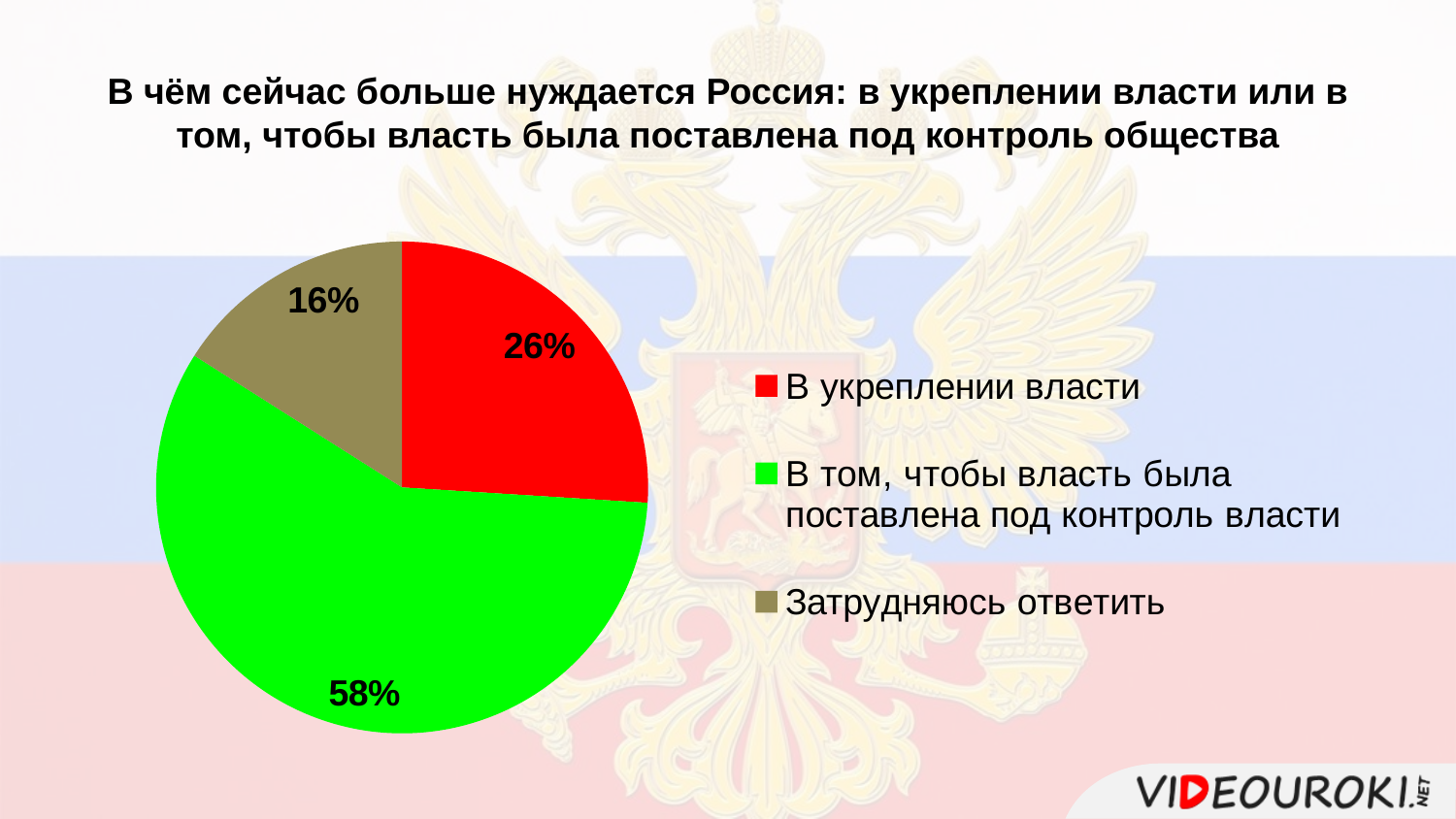
What share of respondents answered "Затрудняюсь ответить"? 16% How many entries does the legend list? 3 Which is larger: the share for "В укреплении власти" or the share for "Затрудняюсь ответить"? В укреплении власти How many slices does the pie chart have? 3 What is the difference in percentage points between "В укреплении власти" and "Затрудняюсь ответить"? 10 What share of respondents chose "В укреплении власти"? 26% What is the difference in percentage points between "В том, чтобы власть была поставлена под контроль власти" and "В укреплении власти"? 32 What share of respondents chose "В том, чтобы власть была поставлена под контроль власти"? 58% What kind of chart is shown on the slide? pie chart Which answer option has the smallest slice of the pie? Затрудняюсь ответить What colour is the slice for "Затрудняюсь ответить"? olive/brown Which answer option has the largest slice of the pie? В том, чтобы власть была поставлена под контроль власти